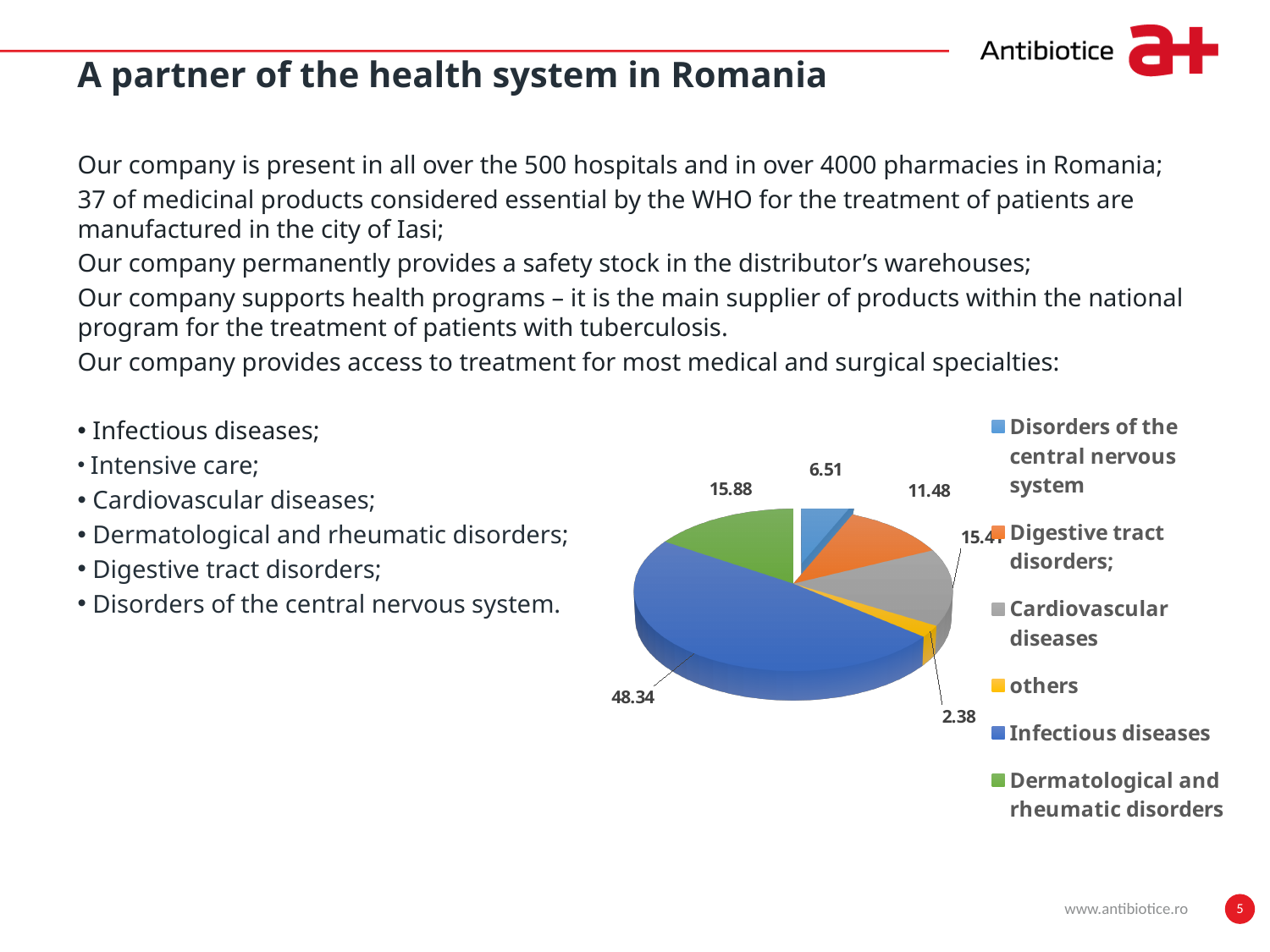
What is the difference between the values for Infectious diseases and Dermatological and rheumatic disorders? 32.46 Which category has the largest slice in the pie chart? Infectious diseases Which is larger in the pie chart: Digestive tract disorders or Disorders of the central nervous system? Digestive tract disorders What is the value shown for Dermatological and rheumatic disorders in the pie chart? 15.88 What is the value shown for Digestive tract disorders in the pie chart? 11.48 What is the value shown for the 'others' slice in the pie chart? 2.38 How many slices does the pie chart have? 6 Which category has the smallest slice in the pie chart? others What kind of chart is shown on the slide? pie chart What is the value shown for Disorders of the central nervous system in the pie chart? 6.51 What colour is the Infectious diseases slice in the pie chart? blue What is the value shown for Infectious diseases in the pie chart? 48.34